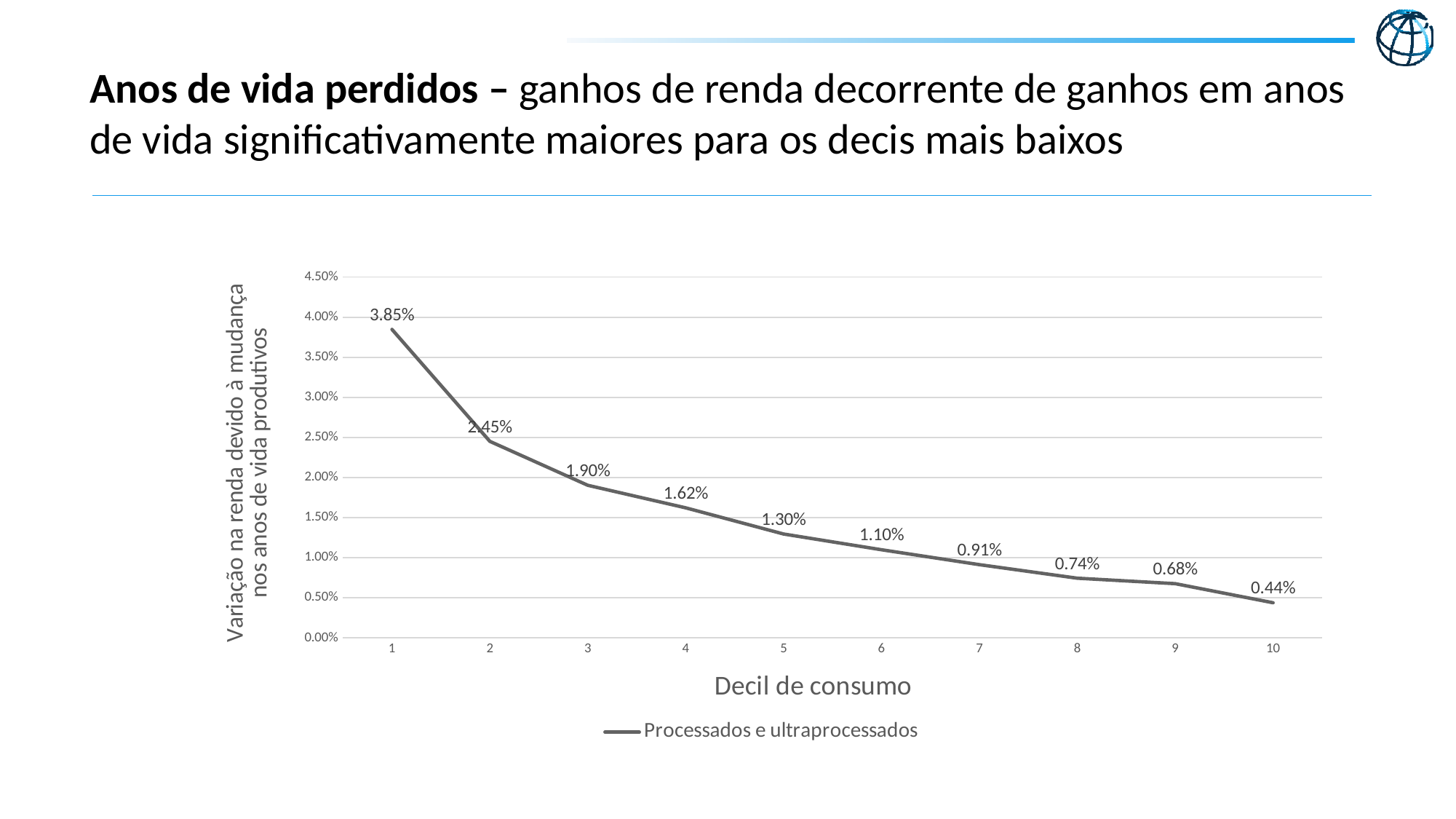
What kind of chart is shown on the slide? Line chart How many series does the legend list? 1 Is the value for decile 4 greater or less than 1.50%? greater What is the value for consumption decile 1? 3.85% How many consumption deciles are plotted on the x axis? 10 What is the value for consumption decile 10? 0.44% What is the difference between the values for decile 1 and decile 2? 1.40% Which consumption decile has the lowest value? 10 Do the values rise or fall as the consumption decile increases from 1 to 10? Fall Which consumption decile has the highest value? 1 What is the value for consumption decile 5? 1.30% Which has a larger value, decile 3 or decile 7? Decile 3